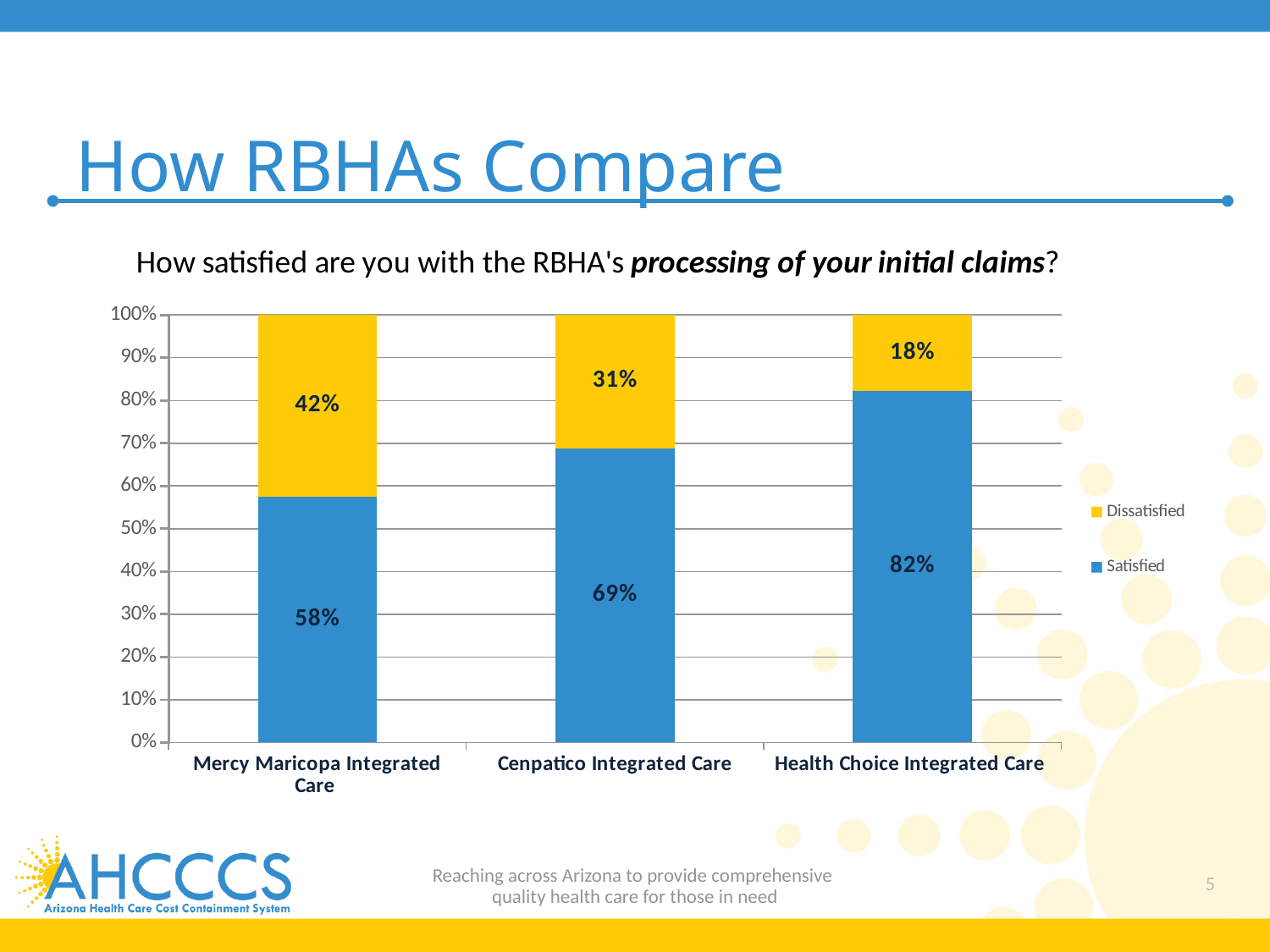
How many series does the chart legend list? 2 What is the difference between the Satisfied percentages for Health Choice Integrated Care and Mercy Maricopa Integrated Care? 24% How many RBHAs are shown on the x axis of the chart? 3 What is the Dissatisfied value for Mercy Maricopa Integrated Care? 42% Which colour represents the Dissatisfied series in the chart? Yellow Which is larger: the Satisfied value for Cenpatico Integrated Care or the Satisfied value for Mercy Maricopa Integrated Care? Cenpatico Integrated Care What type of chart is shown on the slide? Stacked bar chart What percentage of respondents were satisfied with Mercy Maricopa Integrated Care's processing of initial claims? 58% What is the Satisfied value for Health Choice Integrated Care? 82% What is the Dissatisfied value for Cenpatico Integrated Care? 31% Which RBHA has the lowest Dissatisfied percentage? Health Choice Integrated Care Which RBHA has the highest Satisfied percentage? Health Choice Integrated Care